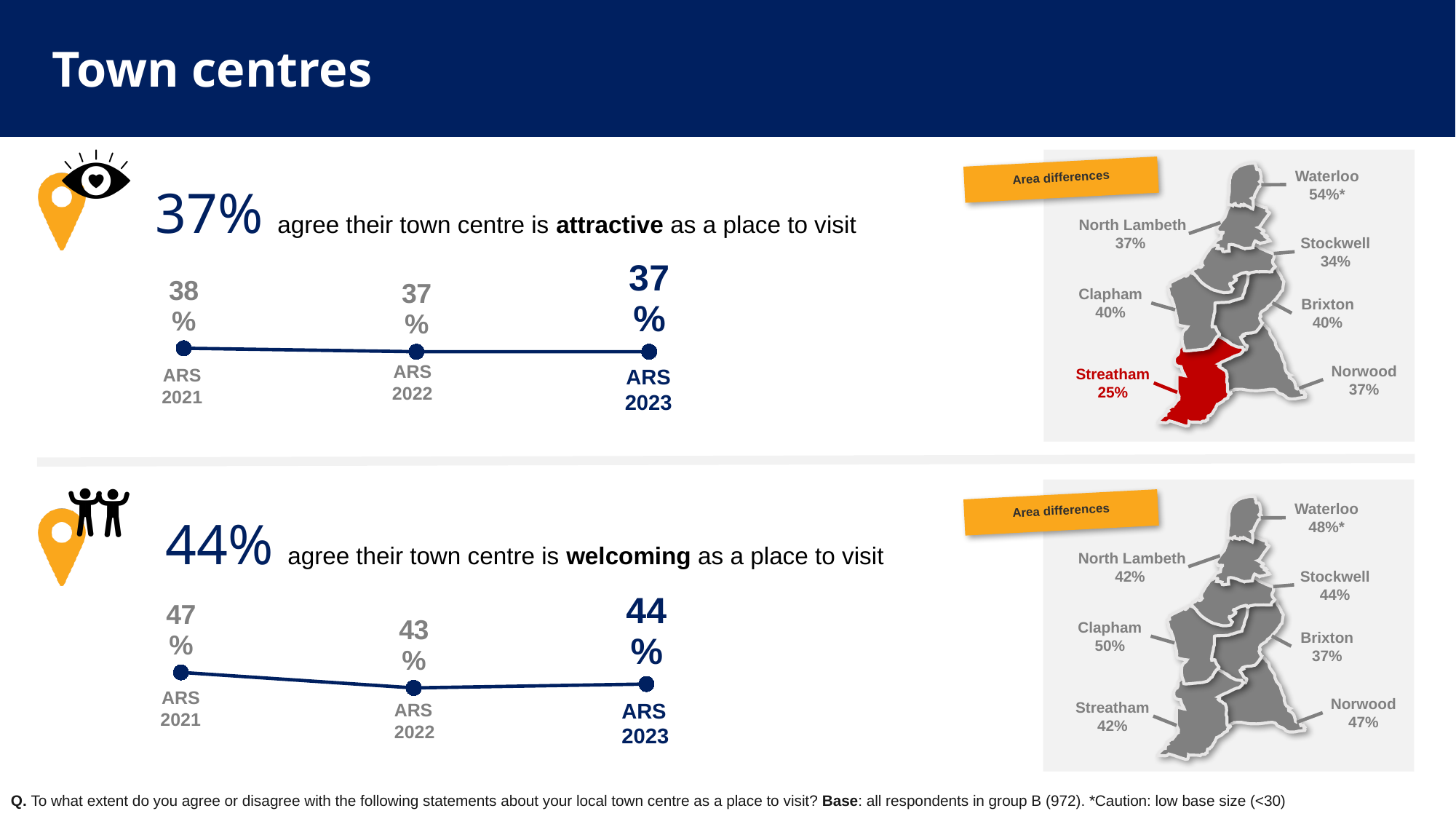
On the 'attractive' line chart (top), what is the value for ARS 2021? 38% On the 'welcoming' line chart (bottom), is the value for ARS 2022 larger or smaller than the value for ARS 2023? smaller On the 'welcoming' line chart (bottom), what is the difference between the ARS 2021 and ARS 2023 values? 3% On the 'welcoming' line chart (bottom), what is the value for ARS 2022? 43% How many data points are plotted on the 'attractive' line chart (top)? 3 What kind of chart is used to show the 'welcoming' results over time (bottom)? line chart On the 'attractive' line chart (top), which year has the highest value? ARS 2021 On the 'welcoming' line chart (bottom), which year has the lowest value? ARS 2022 On the 'attractive' line chart (top), what is the difference between the ARS 2021 and ARS 2022 values? 1% On the 'welcoming' line chart (bottom), which year has the highest value? ARS 2021 On the 'welcoming' line chart (bottom), what is the value for ARS 2021? 47% On the 'attractive' line chart (top), what is the value for ARS 2023? 37%